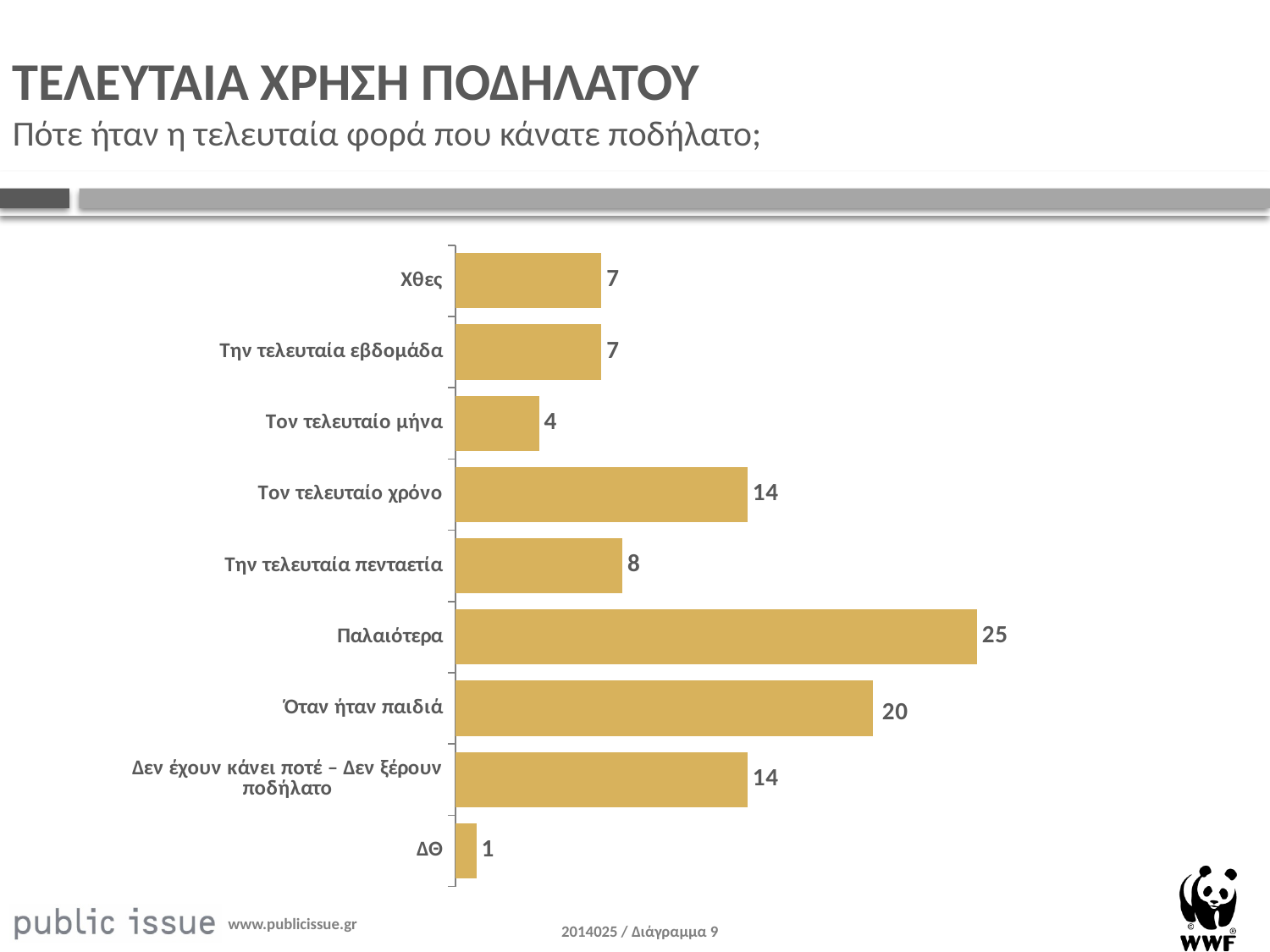
What is the value for Τον τελευταίο μήνα? 4 What is the value for Την τελευταία πενταετία? 8 What is the value for Όταν ήταν παιδιά? 20 What is the difference between the values for Χθες and Τον τελευταίο μήνα? 3 Which category has the highest value? Παλαιότερα How many categories are shown in the chart? 9 Which is larger, the value for Τον τελευταίο χρόνο or the value for Την τελευταία πενταετία? Τον τελευταίο χρόνο What is the title of the chart on the slide? ΤΕΛΕΥΤΑΙΑ ΧΡΗΣΗ ΠΟΔΗΛΑΤΟΥ What kind of chart is shown on the slide? Bar chart What is the difference between the values for Παλαιότερα and Όταν ήταν παιδιά? 5 Which category has the lowest value? ΔΘ What is the value for Παλαιότερα? 25